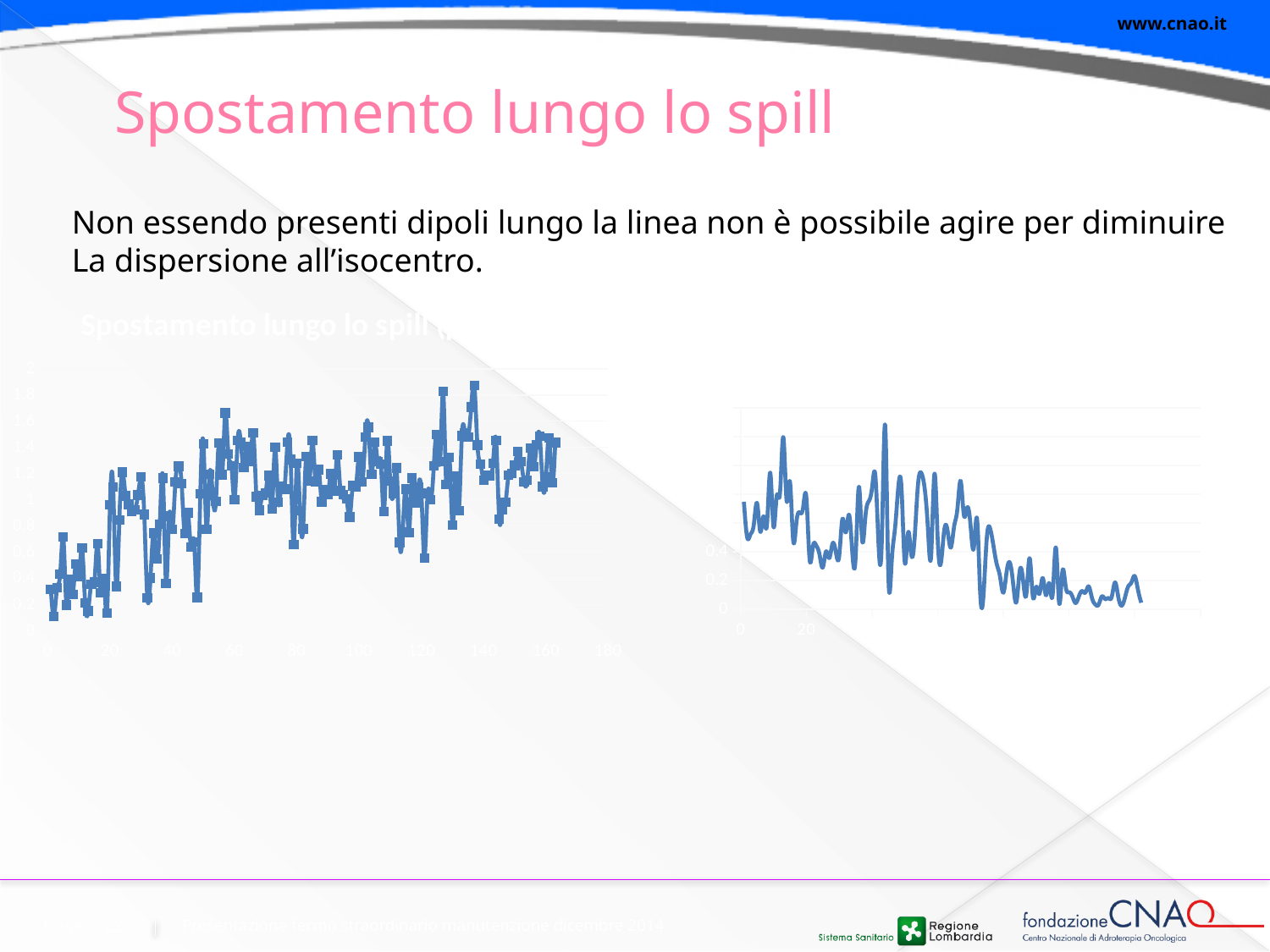
In the left chart titled "Spostamento lungo lo spill", do the values overall rise or fall along the x axis? rise In the left chart titled "Spostamento lungo lo spill", what is the highest tick label on the x axis? 180 In the left chart titled "Spostamento lungo lo spill", what is the highest tick label on the y axis? 2 How many charts are shown on the slide? 2 In the left chart titled "Spostamento lungo lo spill", is the value at x = 0 greater or less than 1? less What kind of chart is the chart on the right side of the slide? line chart In the chart on the right side of the slide, do the values overall rise or fall along the x axis? fall What kind of chart is the left chart titled "Spostamento lungo lo spill"? line chart